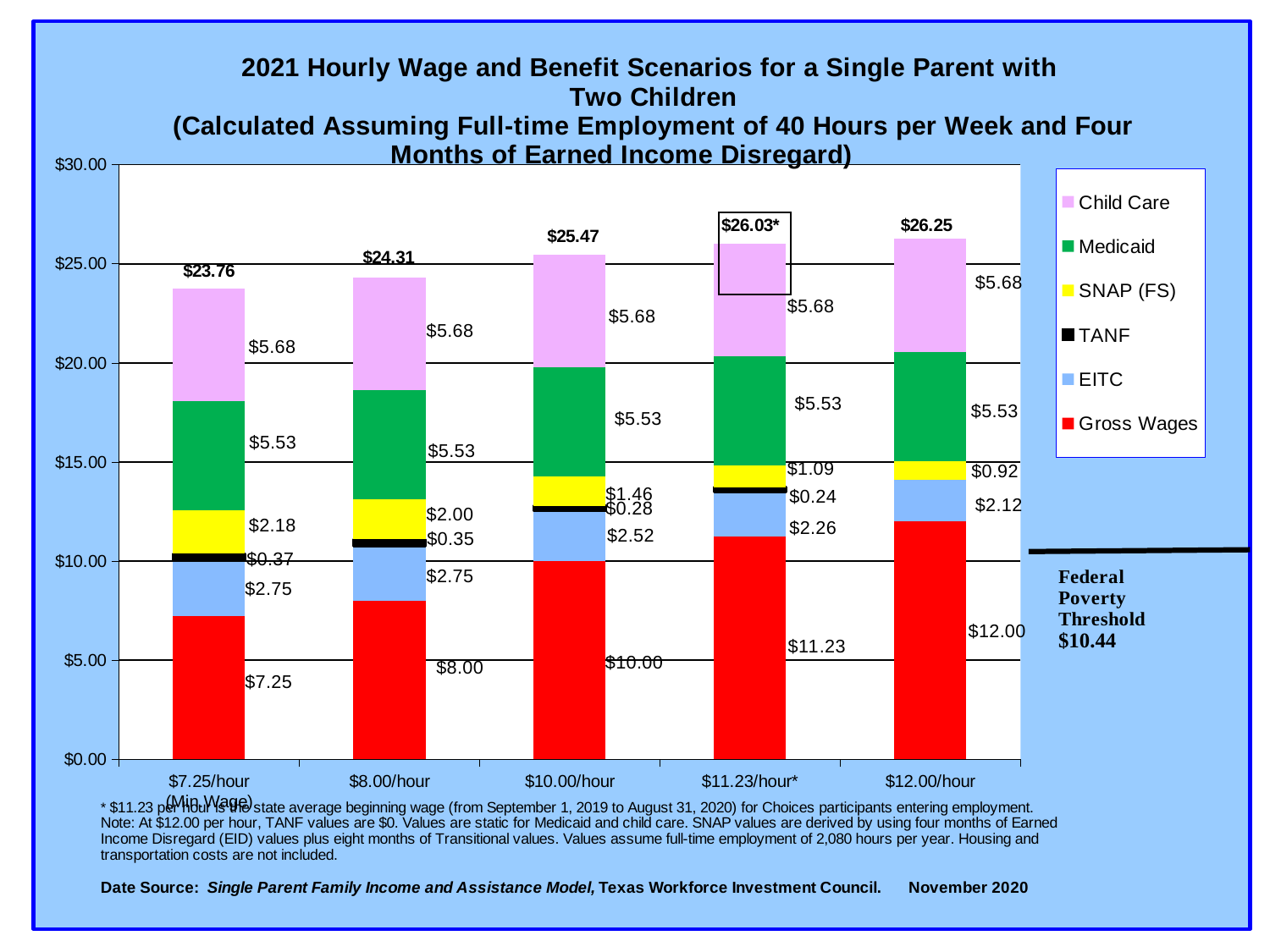
Which wage scenario has the highest total value? $12.00/hour What is the difference between the total for $12.00/hour and the total for $7.25/hour? $2.49 What type of chart is shown on the slide? Stacked bar chart What is the EITC value for the $11.23/hour* scenario? $2.26 How many hourly wage scenarios (bars) are plotted in the chart? 5 What is the total value labeled above the $8.00/hour bar? $24.31 Which wage scenario has the lowest total value? $7.25/hour (Min Wage) What is the TANF value for the $7.25/hour scenario? $0.37 Which is larger, the SNAP (FS) value at $8.00/hour or the SNAP (FS) value at $12.00/hour? $8.00/hour How many series does the legend list? 6 What Federal Poverty Threshold value is shown next to the chart? $10.44 What is the SNAP (FS) value for the $10.00/hour scenario? $1.46